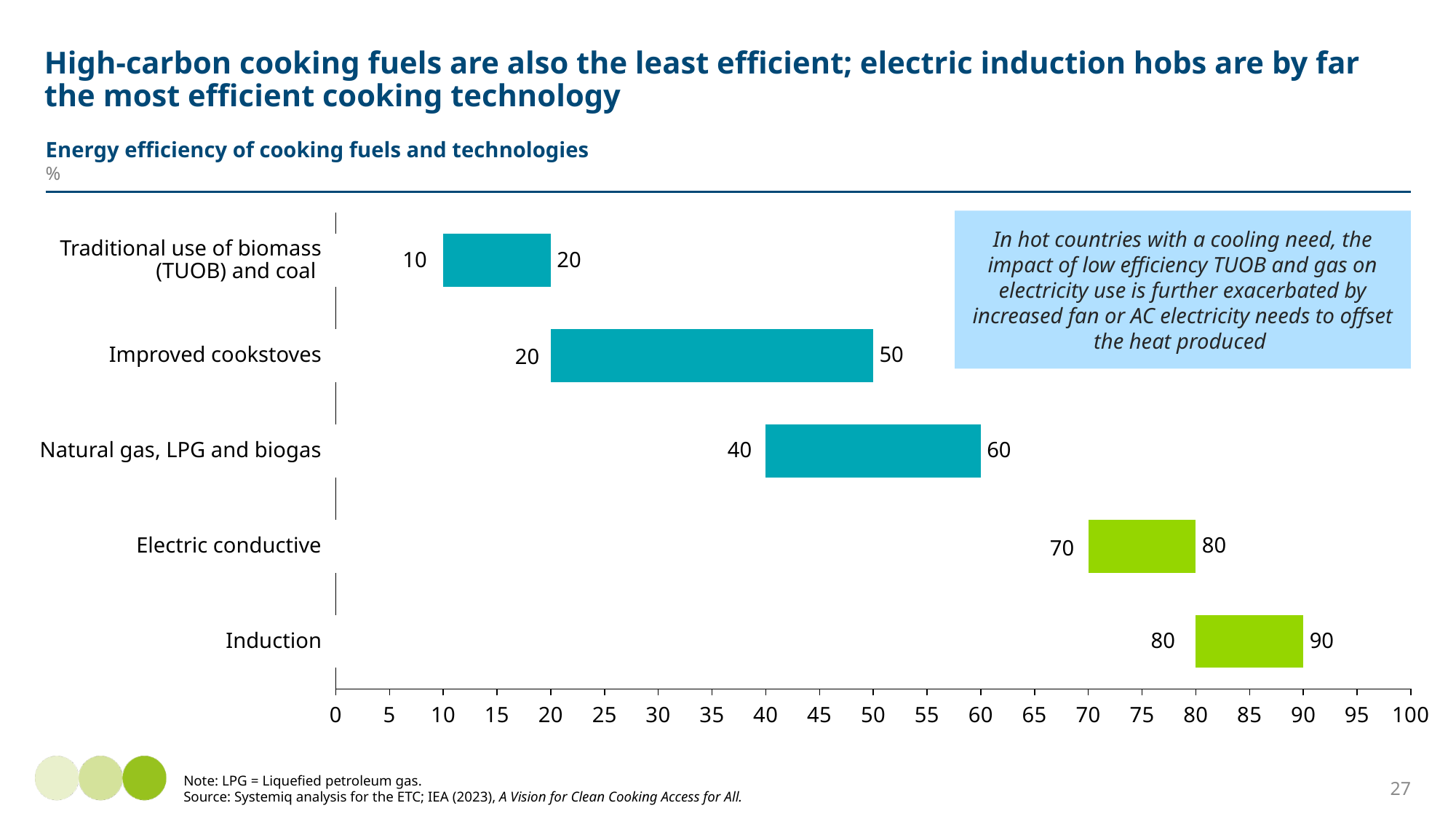
What is the lower end of the energy efficiency range for Natural gas, LPG and biogas? 40 Which has a larger upper-end efficiency value, Natural gas, LPG and biogas or Electric conductive? Electric conductive What kind of chart is shown on the slide? Bar chart What is the lower end of the energy efficiency range for Traditional use of biomass (TUOB) and coal? 10 What is the upper end of the energy efficiency range for Improved cookstoves? 50 Which category has the highest upper-end energy efficiency value? Induction Which category has the lowest lower-end energy efficiency value? Traditional use of biomass (TUOB) and coal What is the title of the chart? Energy efficiency of cooking fuels and technologies What is the width of the energy efficiency range for Improved cookstoves (upper end minus lower end)? 30 How many cooking fuel/technology categories are shown on the chart? 5 How much higher is the upper end of the Induction range than the upper end of the Electric conductive range? 10 What is the upper end of the energy efficiency range for Induction? 90